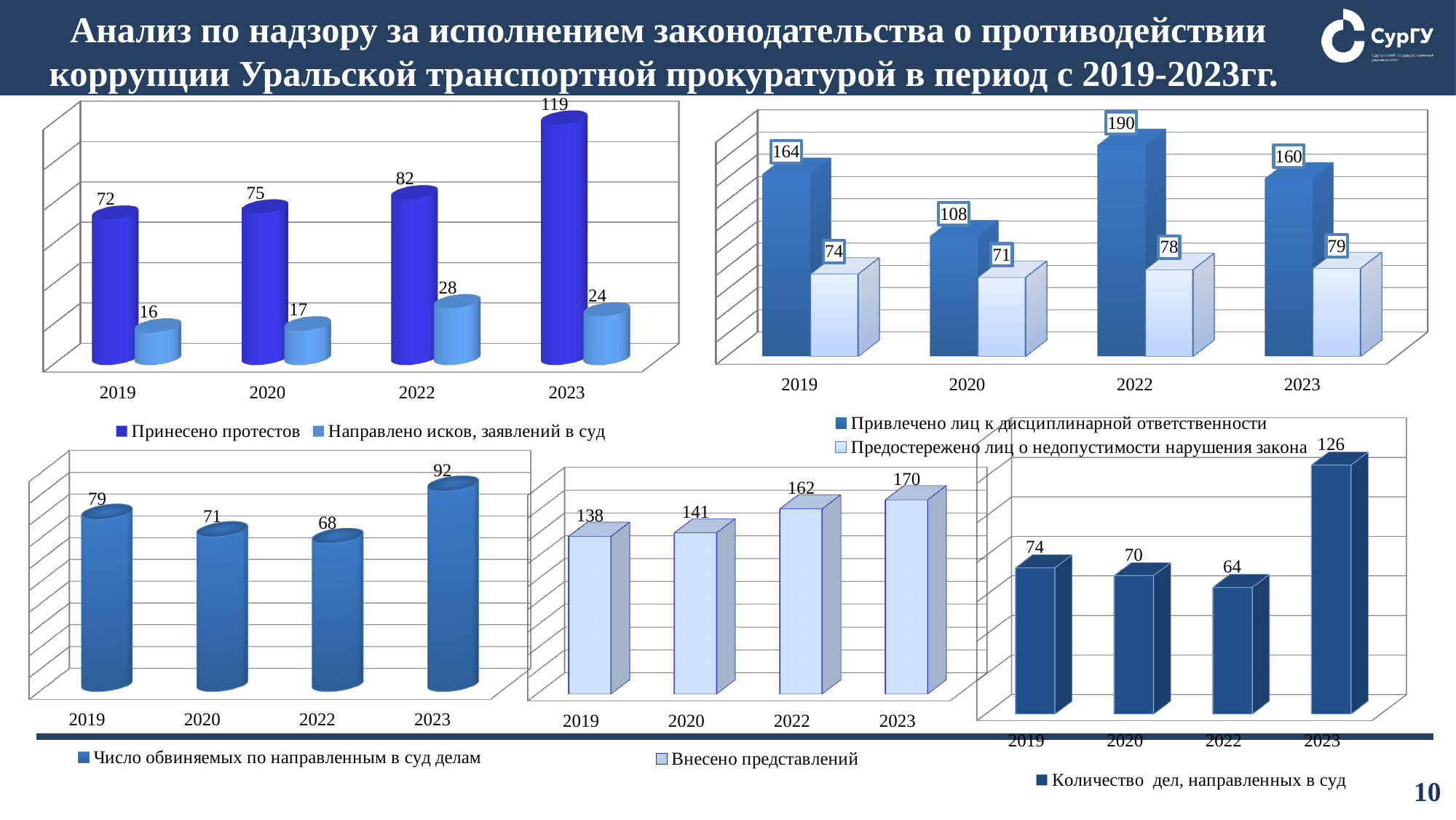
How many year categories are shown on the x axis of the bottom-left chart? 4 In the top-left chart, how many series does the legend list? 2 In the top-right chart, which year has the highest value for 'Привлечено лиц к дисциплинарной ответственности'? 2022 In the bottom-middle chart ('Внесено представлений'), do the values rise or fall from 2019 to 2023? rise In the bottom-left chart ('Число обвиняемых по направленным в суд делам'), which year has the lowest value? 2022 In the bottom-right chart ('Количество дел, направленных в суд'), what is the difference between the 2023 and 2022 values? 62 In the top-left chart, what is the value for 'Направлено исков, заявлений в суд' in 2022? 28 In the top-right chart, what is the value for 'Предостережено лиц о недопустимости нарушения закона' in 2020? 71 In the bottom-right chart ('Количество дел, направленных в суд'), which is larger, the value for 2019 or the value for 2020? 2019 In the top-left chart, what is the value for 'Принесено протестов' in 2023? 119 In the bottom-middle chart ('Внесено представлений'), what is the value for 2020? 141 In the top-right chart, what is the difference between 'Привлечено лиц к дисциплинарной ответственности' and 'Предостережено лиц о недопустимости нарушения закона' in 2019? 90